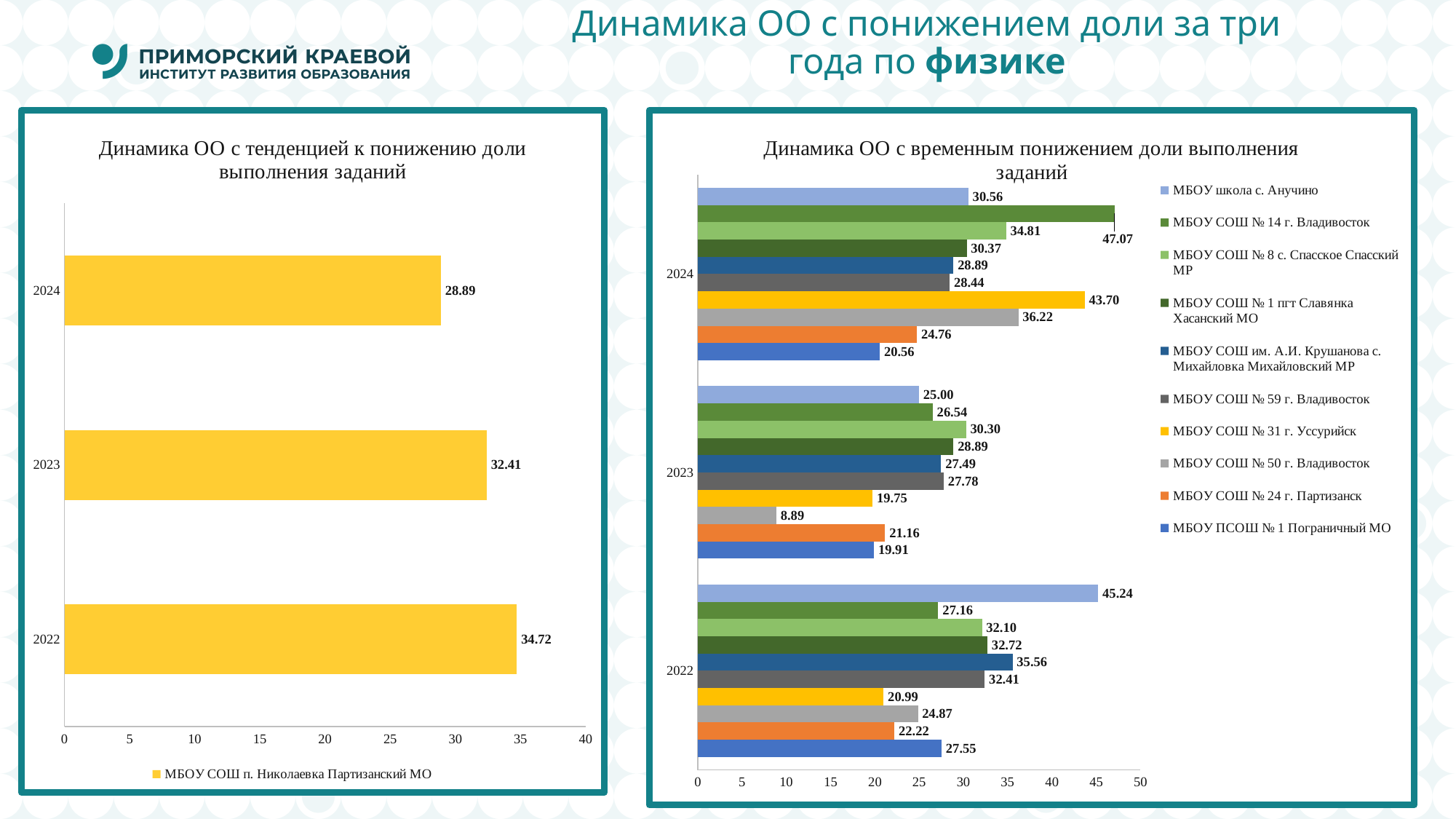
What kind of chart is the right chart 'Динамика ОО с временным понижением доли выполнения заданий'? bar chart In the left chart 'Динамика ОО с тенденцией к понижению доли выполнения заданий', what is the value for 2024? 28.89 In the left chart 'Динамика ОО с тенденцией к понижению доли выполнения заданий', which series does the legend show? МБОУ СОШ п. Николаевка Партизанский МО In the left chart 'Динамика ОО с тенденцией к понижению доли выполнения заданий', which year has the highest value? 2022 In the left chart 'Динамика ОО с тенденцией к понижению доли выполнения заданий', what is the difference between the 2022 and 2024 values? 5.83 In the right chart 'Динамика ОО с временным понижением доли выполнения заданий', what is the value for МБОУ СОШ № 50 г. Владивосток in 2023? 8.89 In the right chart 'Динамика ОО с временным понижением доли выполнения заданий', which school has the lowest value in 2023? МБОУ СОШ № 50 г. Владивосток In the right chart 'Динамика ОО с временным понижением доли выполнения заданий', what is the value for МБОУ СОШ № 14 г. Владивосток in 2024? 47.07 In the right chart 'Динамика ОО с временным понижением доли выполнения заданий', which is larger in 2024: МБОУ СОШ № 31 г. Уссурийск or МБОУ СОШ № 50 г. Владивосток? МБОУ СОШ № 31 г. Уссурийск In the right chart 'Динамика ОО с временным понижением доли выполнения заданий', how many series does the legend list? 10 In the right chart 'Динамика ОО с временным понижением доли выполнения заданий', which school has the highest value in 2022? МБОУ школа с. Анучино In the left chart 'Динамика ОО с тенденцией к понижению доли выполнения заданий', do the values rise or fall from 2022 to 2024? fall